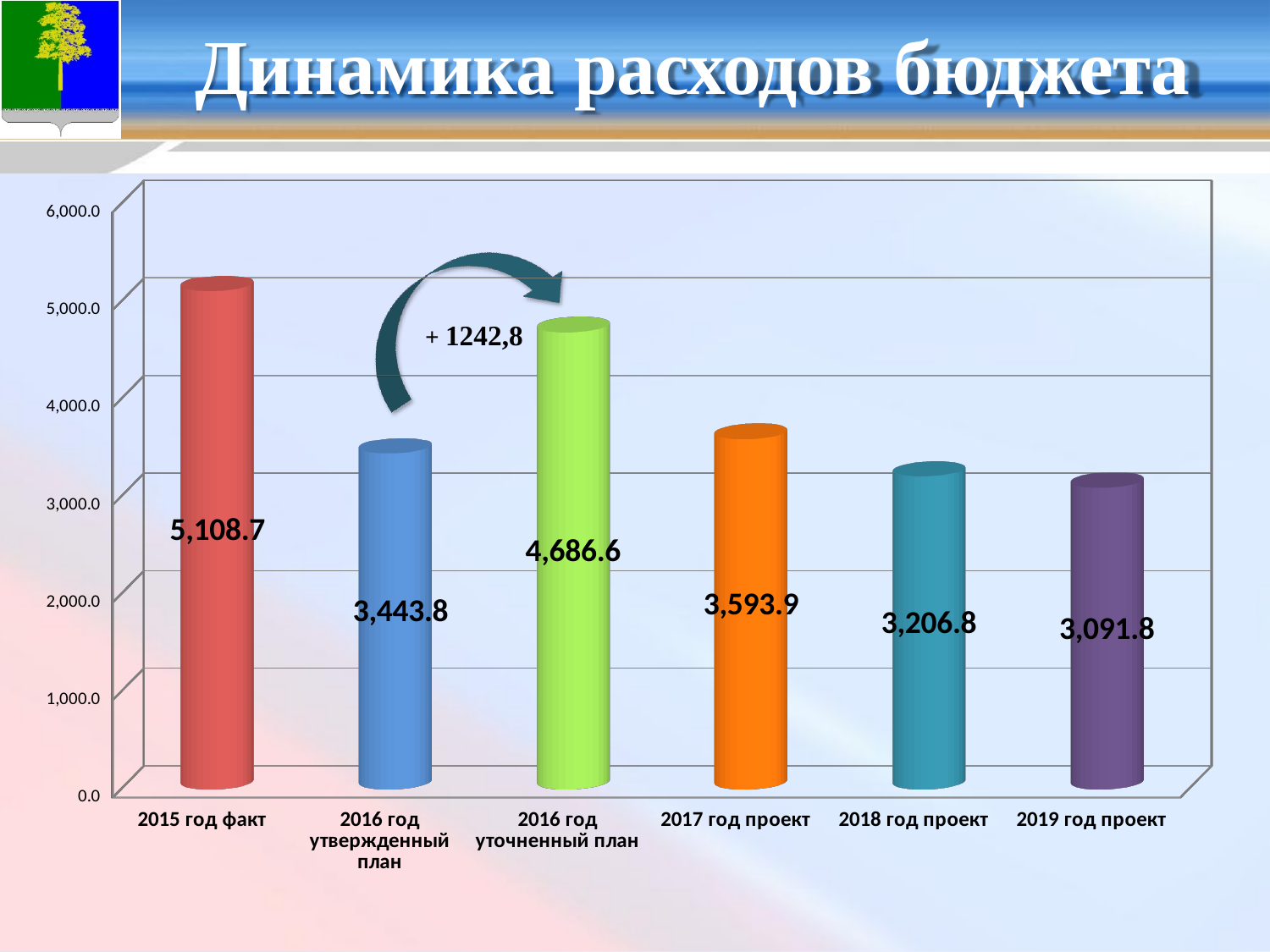
What kind of chart is shown on the slide? bar chart What is the difference between 2015 год факт and 2016 год уточненный план? 422.1 Do the values rise or fall from 2017 год проект to 2019 год проект? fall What is the difference between 2016 год уточненный план and 2016 год утвержденный план? 1,242.8 Is the value for 2016 год утвержденный план greater or less than 4,000.0? less How many categories are shown on the chart? 6 Which category has the lowest value? 2019 год проект What is the value for 2015 год факт? 5,108.7 What is the value for 2016 год уточненный план? 4,686.6 Which is larger, the value for 2017 год проект or 2018 год проект? 2017 год проект Which category has the highest value? 2015 год факт What is the value for 2019 год проект? 3,091.8